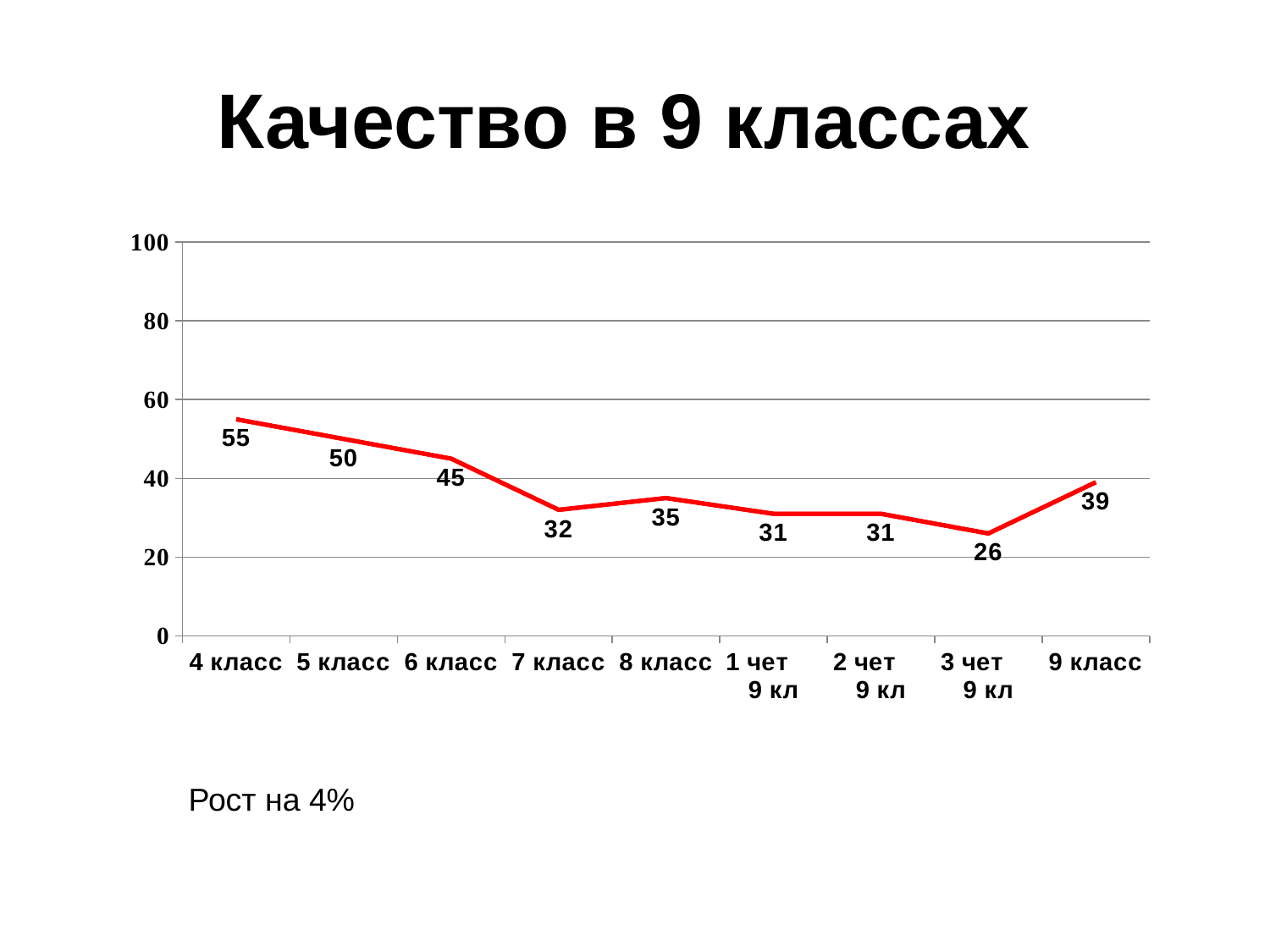
Which is larger, the value for 8 класс or the value for 7 класс? 8 класс What kind of chart is shown on the slide? line chart What is the value for 3 чет 9 кл? 26 How many data points are plotted on the chart? 9 What is the title of the chart? Качество в 9 классах What is the value for 9 класс? 39 Do the values rise or fall from 4 класс to 7 класс? fall Which category has the lowest value? 3 чет 9 кл What is the value for 4 класс? 55 What is the difference between the values for 4 класс and 9 класс? 16 What is the value for 7 класс? 32 Which category has the highest value? 4 класс